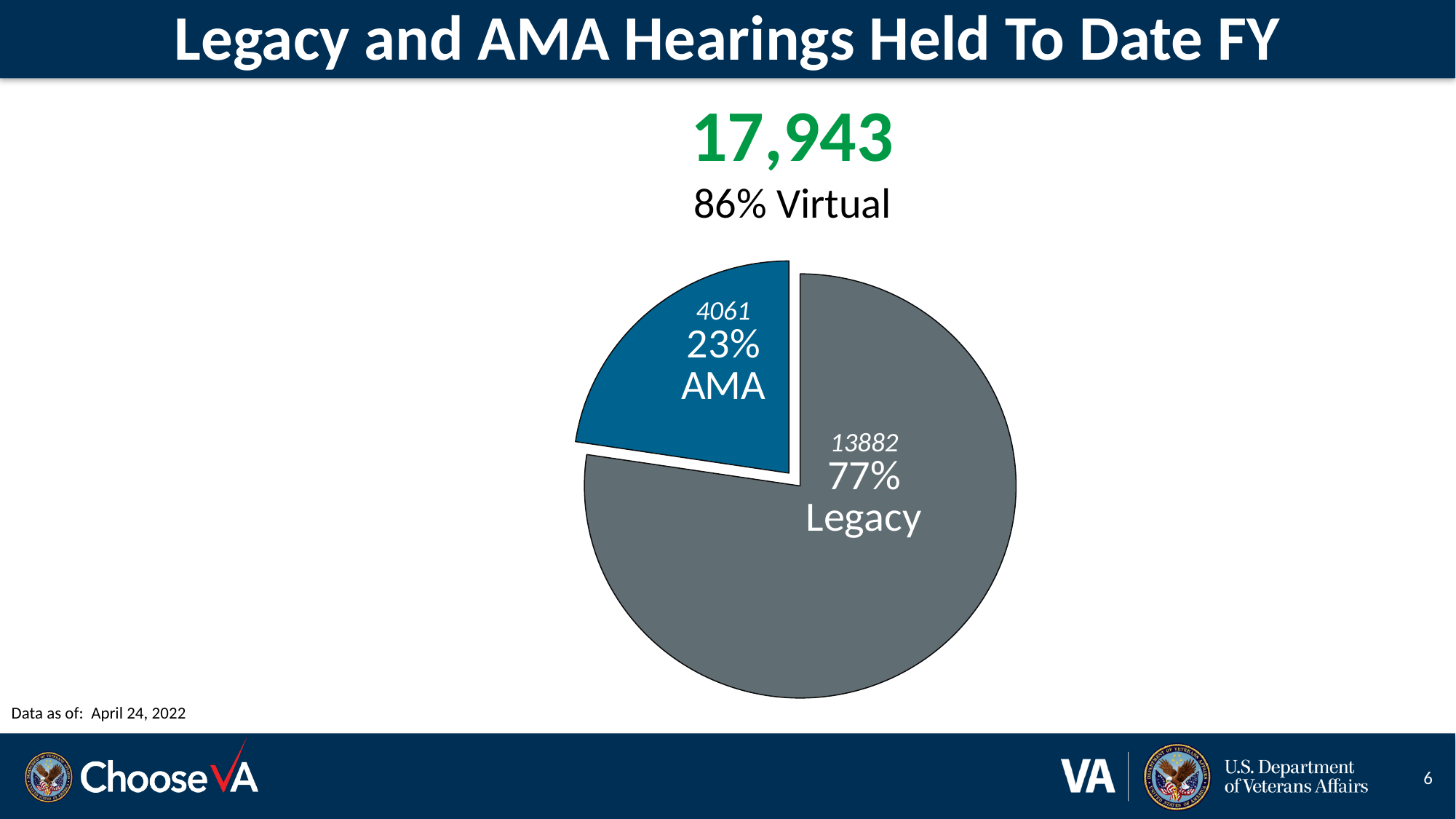
What kind of chart is shown on the slide? Pie chart What is the difference between the Legacy value and the AMA value? 9821 How many slices does the pie chart have? 2 What colour is the AMA slice of the pie chart? Blue What is the value shown for the AMA slice? 4061 What total number of hearings is shown above the pie chart? 17,943 Which slice is the smallest in the pie chart? AMA Which slice is the largest in the pie chart? Legacy What percentage share of the pie is the AMA slice? 23% What percentage share of the pie is the Legacy slice? 77% What is the value shown for the Legacy slice? 13882 Which is larger, the AMA slice or the Legacy slice? Legacy